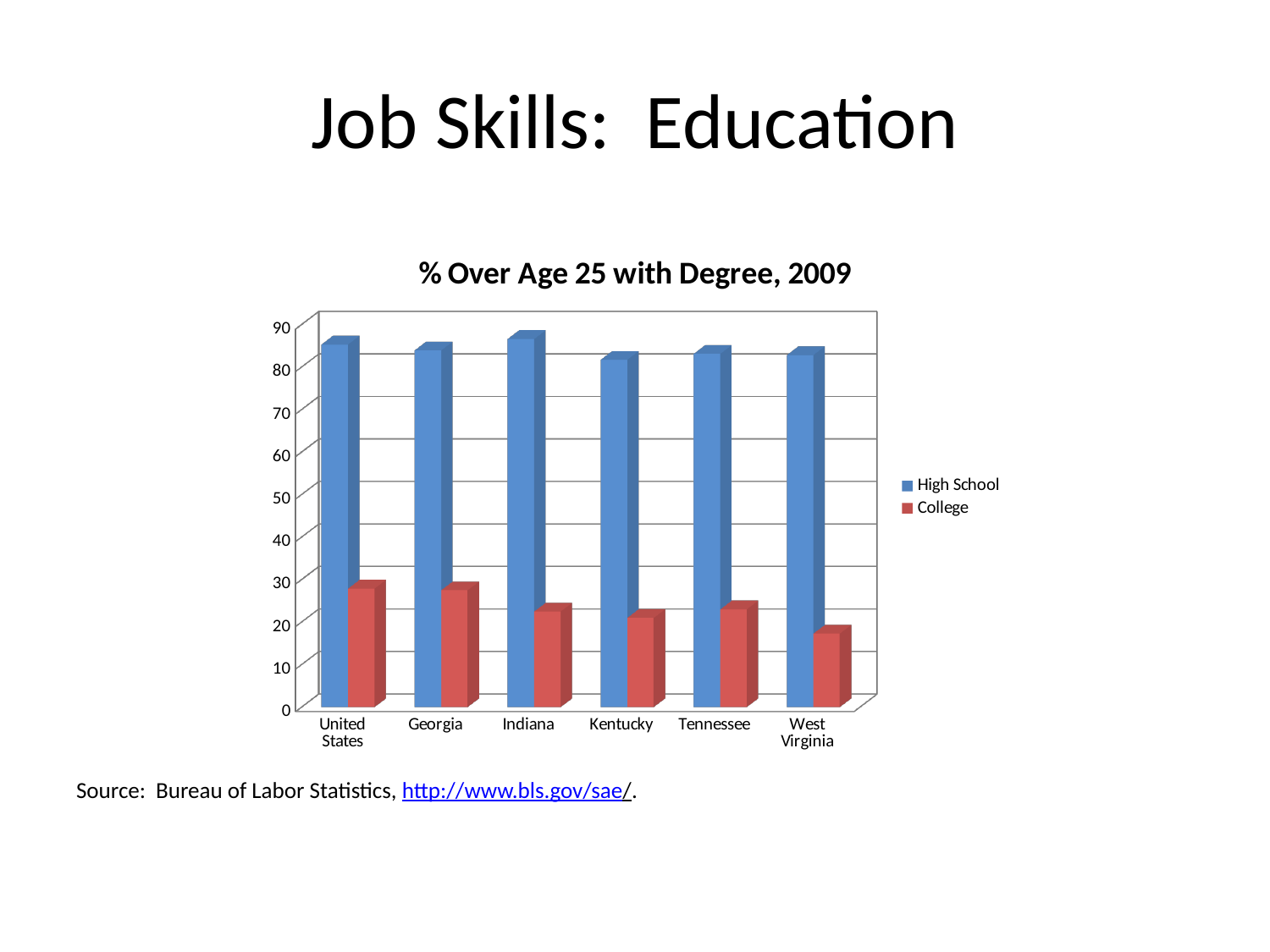
Is the High School value for Kentucky greater or less than 70? greater Which category has the highest High School value? Indiana Which category has the lowest College value? West Virginia How many categories are shown on the x axis? 6 Is the College value for United States greater or less than 20? greater What is the title of the chart? % Over Age 25 with Degree, 2009 Is the College value for West Virginia greater or less than 20? less Which is larger, the High School value for Indiana or for Kentucky? Indiana What kind of chart is shown on the slide? Bar chart How many series does the legend list? 2 Which is larger, the College value for Georgia or for Indiana? Georgia Which series is shown in blue in the legend? High School